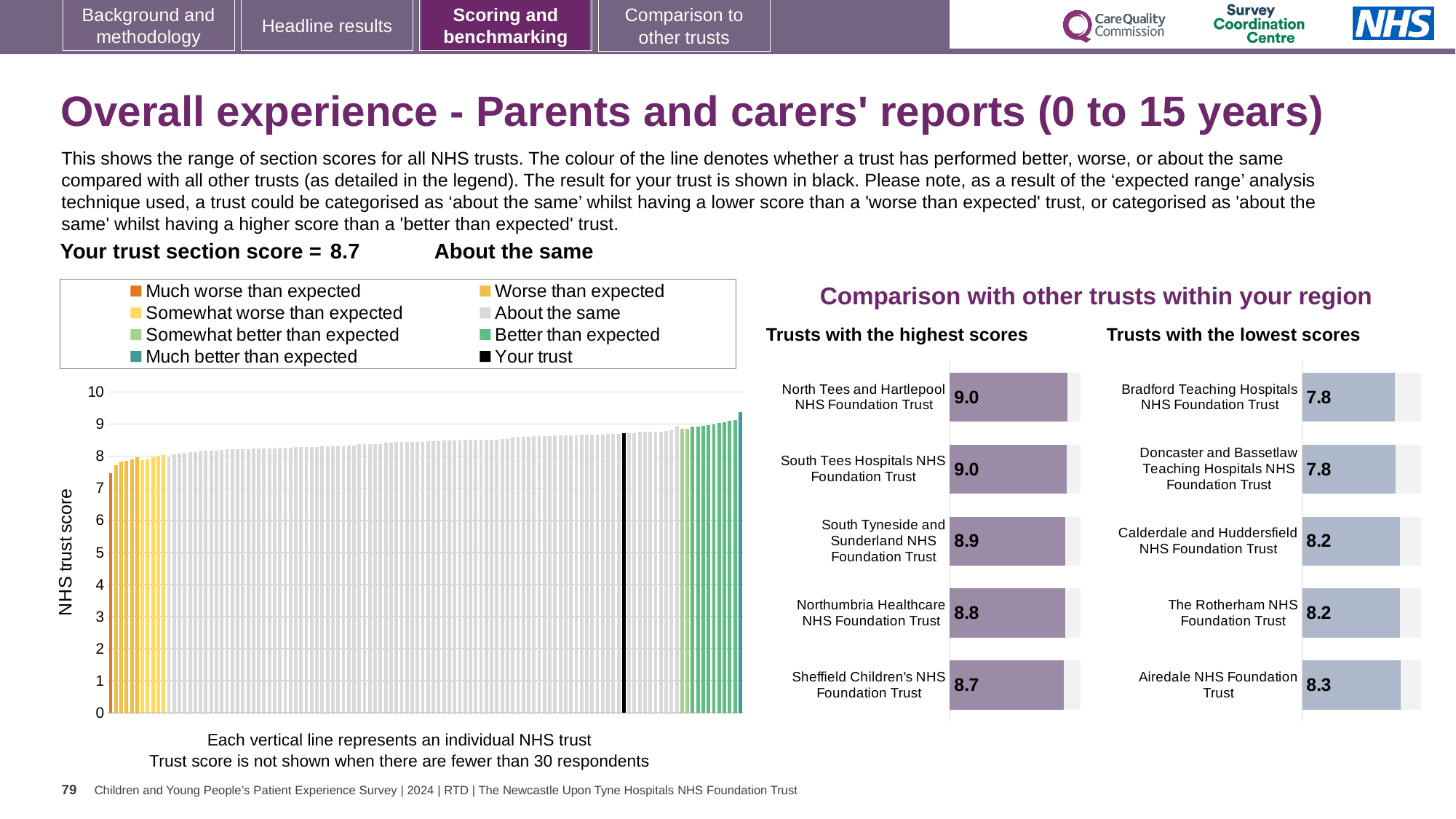
What kind of chart is the large chart on the left showing all NHS trusts? Bar chart In the large chart on the left showing all NHS trusts, is the value for the black 'Your trust' bar greater or less than 8? greater In the 'Trusts with the lowest scores' chart, what is the score for Airedale NHS Foundation Trust? 8.3 How many entries does the legend of the large chart on the left list? 8 In the 'Trusts with the lowest scores' chart, what is the score for Bradford Teaching Hospitals NHS Foundation Trust? 7.8 In the 'Trusts with the highest scores' chart, what is the score for North Tees and Hartlepool NHS Foundation Trust? 9.0 In the 'Trusts with the highest scores' chart, which trust has the lowest score shown? Sheffield Children's NHS Foundation Trust In the 'Trusts with the highest scores' chart, which has the higher score: South Tyneside and Sunderland NHS Foundation Trust or Northumbria Healthcare NHS Foundation Trust? South Tyneside and Sunderland NHS Foundation Trust In the 'Trusts with the lowest scores' chart, which trust has the highest score shown? Airedale NHS Foundation Trust In the 'Trusts with the lowest scores' chart, what is the difference between the scores of Airedale NHS Foundation Trust and Bradford Teaching Hospitals NHS Foundation Trust? 0.5 How many trusts are listed in the 'Trusts with the lowest scores' chart? 5 In the 'Trusts with the highest scores' chart, what is the score for Sheffield Children's NHS Foundation Trust? 8.7